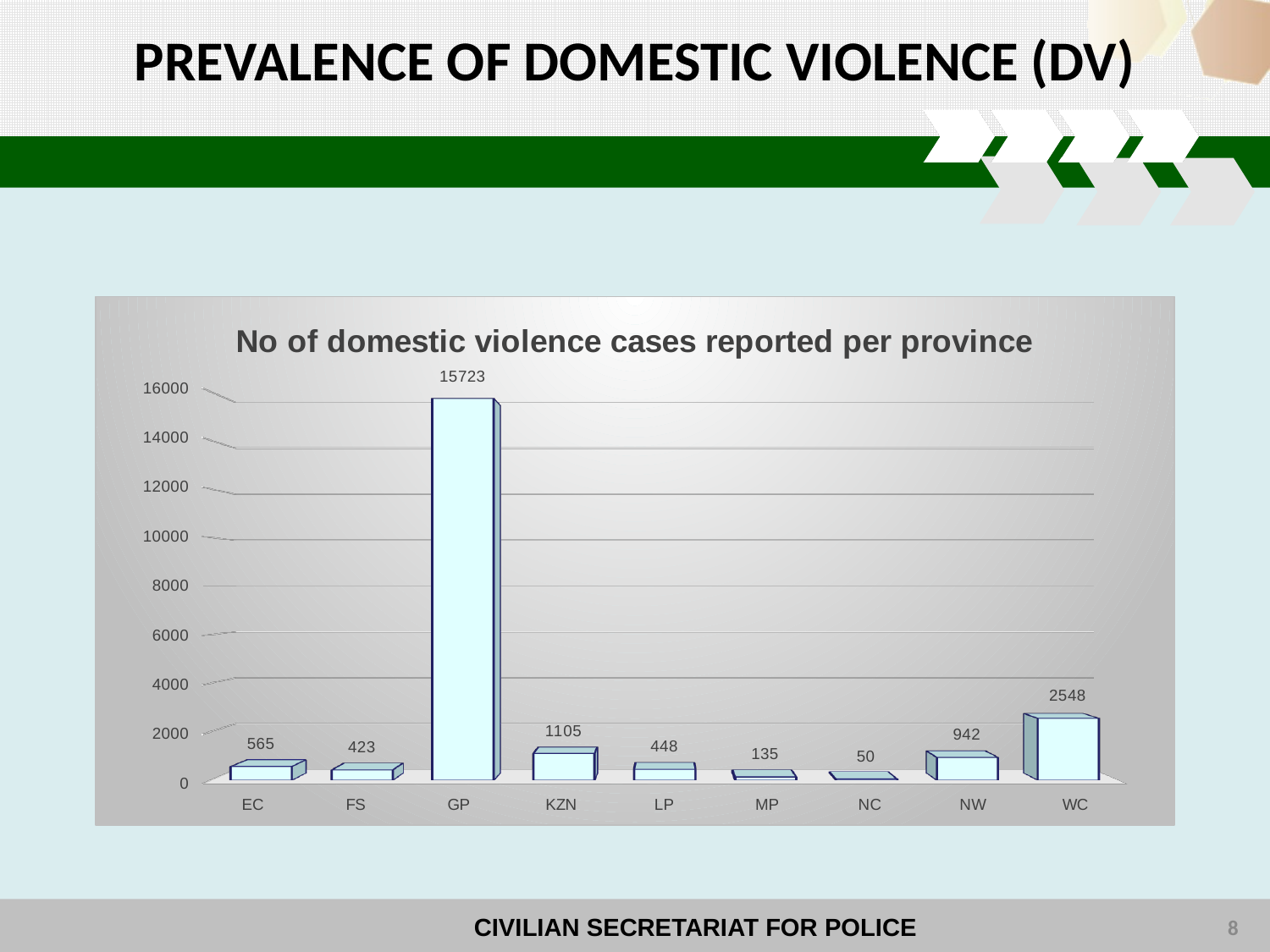
What is the title of the chart? No of domestic violence cases reported per province Is the value for GP greater or less than 14000? greater What is the number of domestic violence cases reported for GP? 15723 What kind of chart is shown on the slide? Bar chart What is the difference between the number of cases reported for MP and NC? 85 What is the number of domestic violence cases reported for KZN? 1105 What is the number of domestic violence cases reported for WC? 2548 Which province has the lowest number of reported domestic violence cases? NC What is the difference between the number of cases reported for WC and NW? 1606 How many provinces are shown on the x axis of the chart? 9 Which has more reported cases, EC or FS? EC Which province has the highest number of reported domestic violence cases? GP